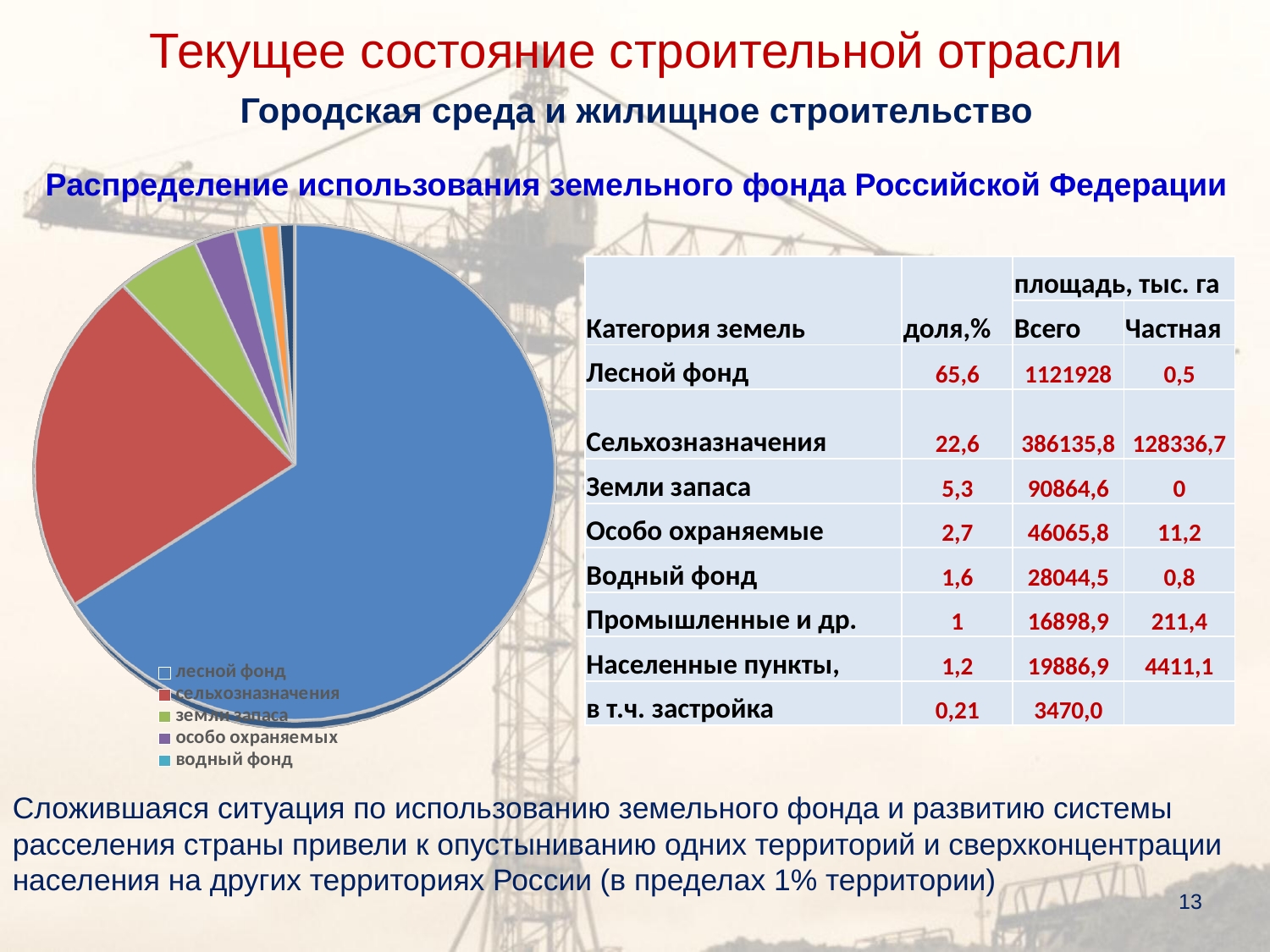
Which slice is larger in the pie chart: сельхозназначения or земли запаса? сельхозназначения What is the difference in share (доля, %) between лесной фонд and сельхозназначения? 43 What colour is the лесной фонд slice in the pie chart? blue Of the categories listed in the pie chart legend, which has the smallest slice? водный фонд According to the slide, what share (доля, %) does сельхозназначения have? 22,6 According to the slide, what share (доля, %) does лесной фонд have? 65,6 What colour is the сельхозназначения slice in the pie chart? red How many slices does the pie chart have? 7 Which slice is larger in the pie chart: земли запаса or особо охраняемые? земли запаса Which category has the largest slice in the pie chart? лесной фонд What kind of chart is shown on the slide? pie chart Is the share of лесной фонд in the pie chart greater or less than 50%? greater